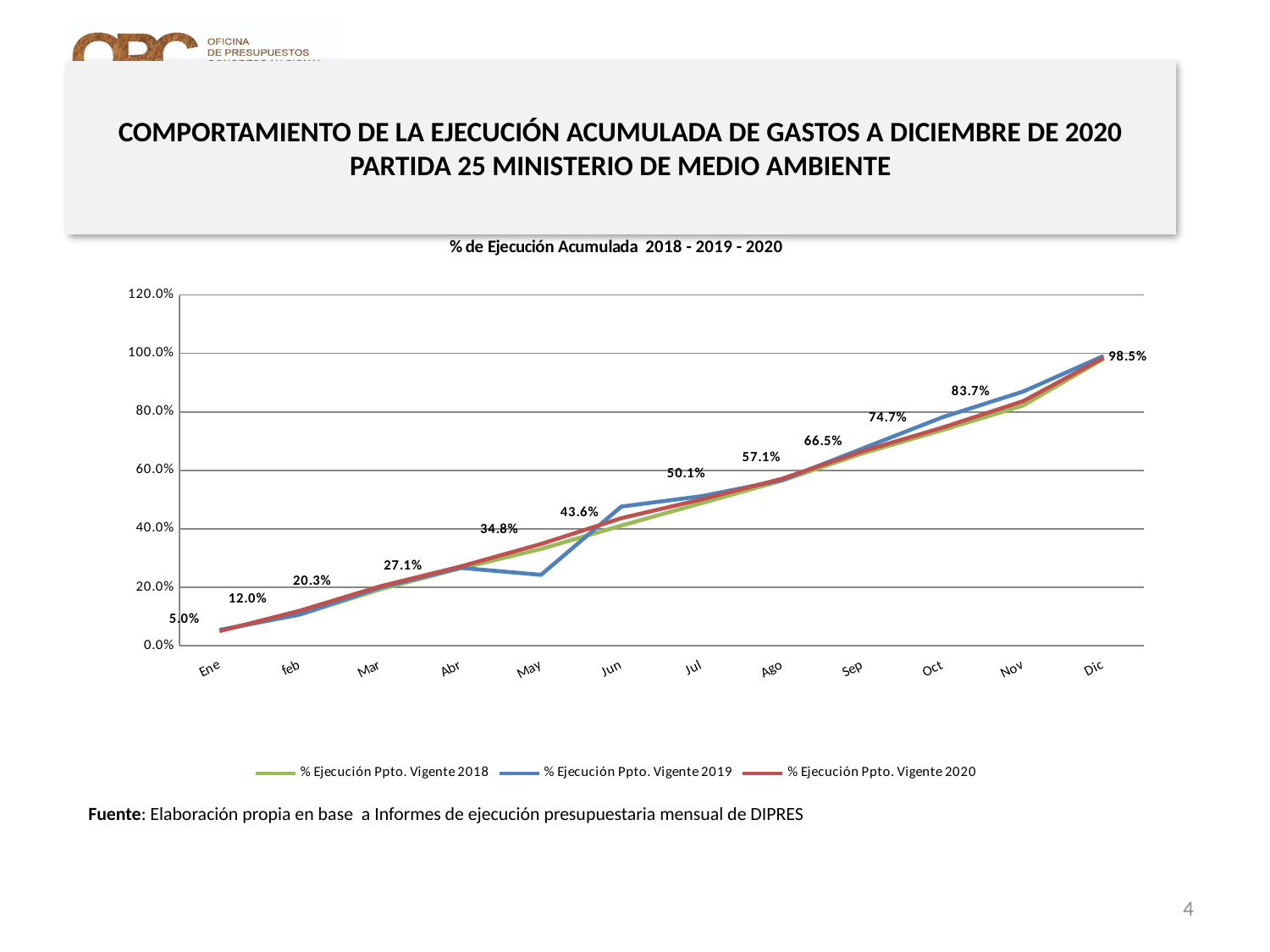
Which month has the lowest labelled value? Ene Which month has the highest labelled value? Dic What is the data label shown at Dic? 98.5% What is the data label shown at Jun? 43.6% What is the difference between the labelled values at Dic and Nov? 14.8% What is the data label shown at Ene? 5.0% Is the value for % Ejecución Ppto. Vigente 2019 at May greater or less than 30%? less What type of chart is shown on the slide? line chart How many months are shown on the x axis? 12 What is the data label shown at Sep? 66.5% How many series does the legend list? 3 Do the values generally rise or fall from Ene to Dic? rise